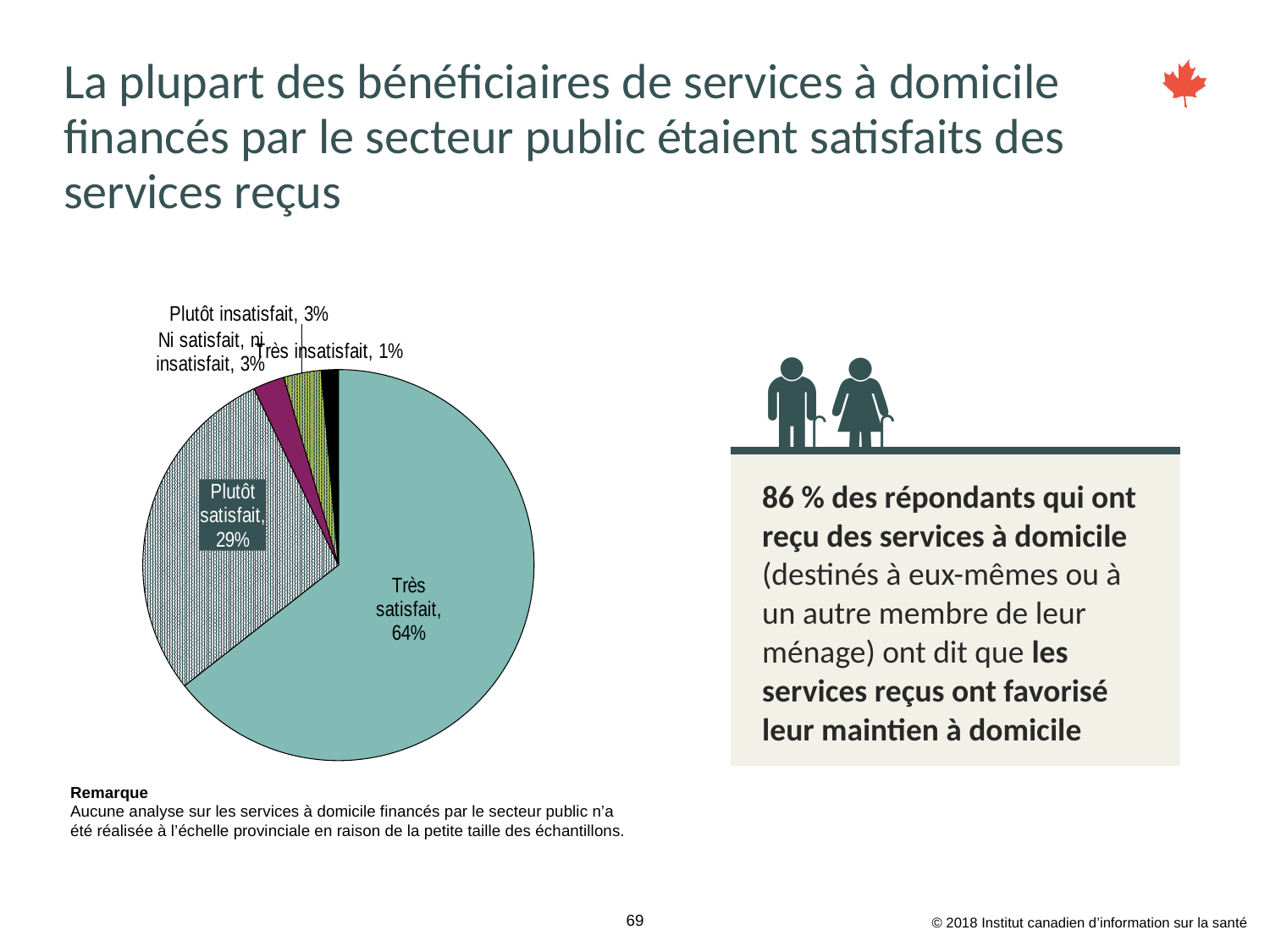
How many slices does the pie chart have? 5 What is the combined share of the "Très satisfait" and "Plutôt satisfait" slices? 93% Which category has the largest slice of the pie? Très satisfait What kind of chart is shown on the slide? Pie chart Which slice of the pie is shown in solid teal? Très satisfait What share of the pie is labelled "Très satisfait"? 64% What share of the pie is labelled "Très insatisfait"? 1% Which category has the smallest slice of the pie? Très insatisfait What share of the pie is labelled "Plutôt insatisfait"? 3% What share of the pie is labelled "Plutôt satisfait"? 29% Which slice is larger, "Plutôt satisfait" or "Ni satisfait, ni insatisfait"? Plutôt satisfait What is the difference in percentage points between the "Très satisfait" and "Plutôt satisfait" slices? 35